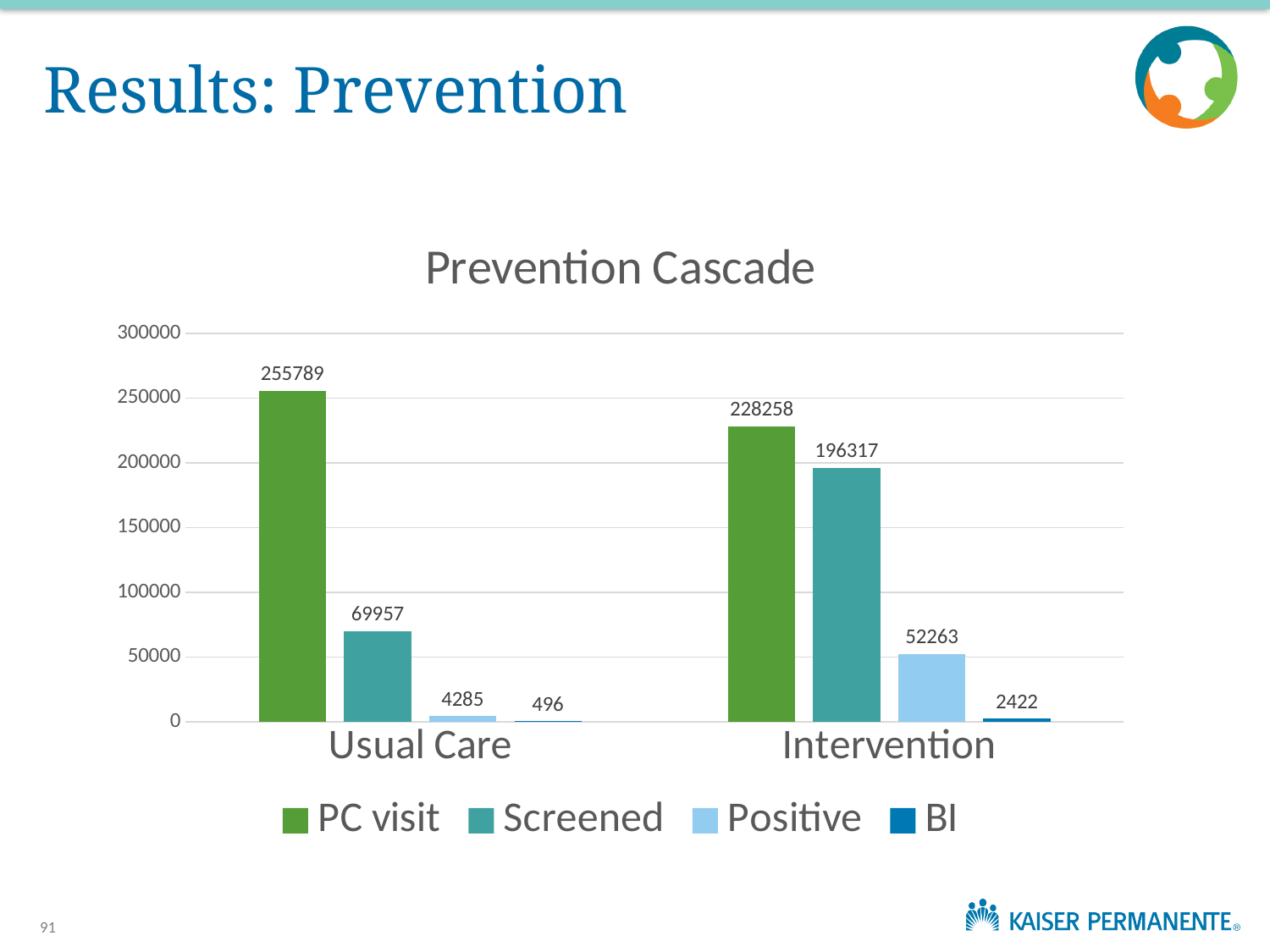
Which series has the highest value in the Intervention group? PC visit Which is larger, the PC visit value for Usual Care or for Intervention? Usual Care What is the BI value for Usual Care? 496 Which series has the lowest value in the Usual Care group? BI How many categories are shown on the x axis? 2 What is the title of the chart? Prevention Cascade What is the difference between the Screened values for Intervention and Usual Care? 126360 How many series does the legend list? 4 What is the Positive value for Intervention? 52263 Is the Screened value for Usual Care greater or less than 100000? less What is the Screened value for Intervention? 196317 What is the PC visit value for Usual Care? 255789